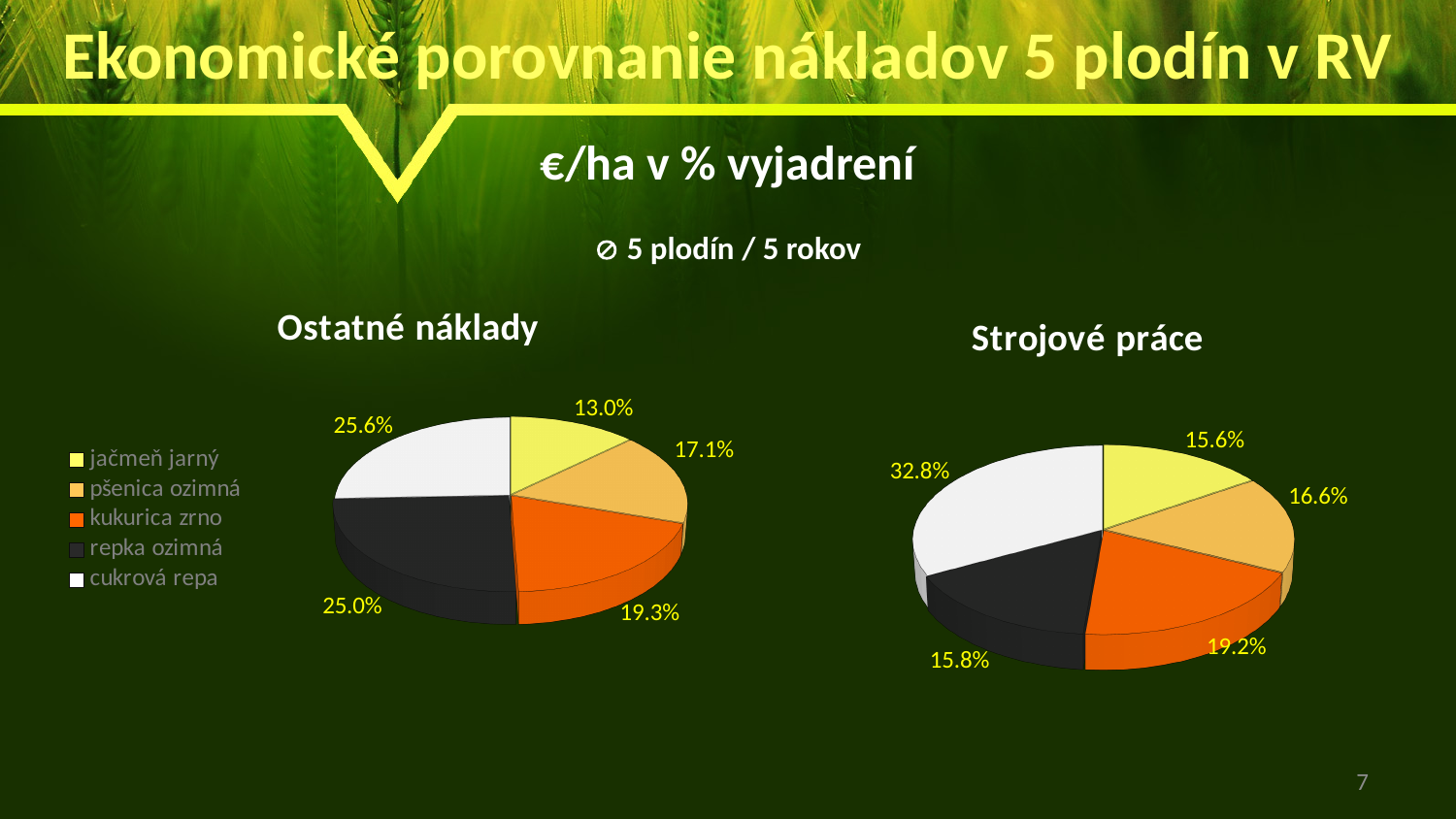
In the 'Ostatné náklady' chart, what is the difference between the shares of cukrová repa and jačmeň jarný? 12.6% In the 'Strojové práce' chart, which crop has the largest share? cukrová repa In the 'Ostatné náklady' chart, which crop has the smallest share? jačmeň jarný In the 'Strojové práce' chart, which crop has the smallest share? jačmeň jarný What type of chart is used for 'Ostatné náklady'? pie chart In the 'Strojové práce' chart, what share does cukrová repa have? 32.8% In the 'Ostatné náklady' chart, what share does kukurica zrno have? 19.3% In the 'Strojové práce' chart, which is larger: the share of kukurica zrno or the share of pšenica ozimná? kukurica zrno How many crops are shown in the legend? 5 In the 'Ostatné náklady' chart, what share does jačmeň jarný have? 13.0% In the 'Strojové práce' chart, what share does repka ozimná have? 15.8% Which colour represents kukurica zrno in the legend? orange